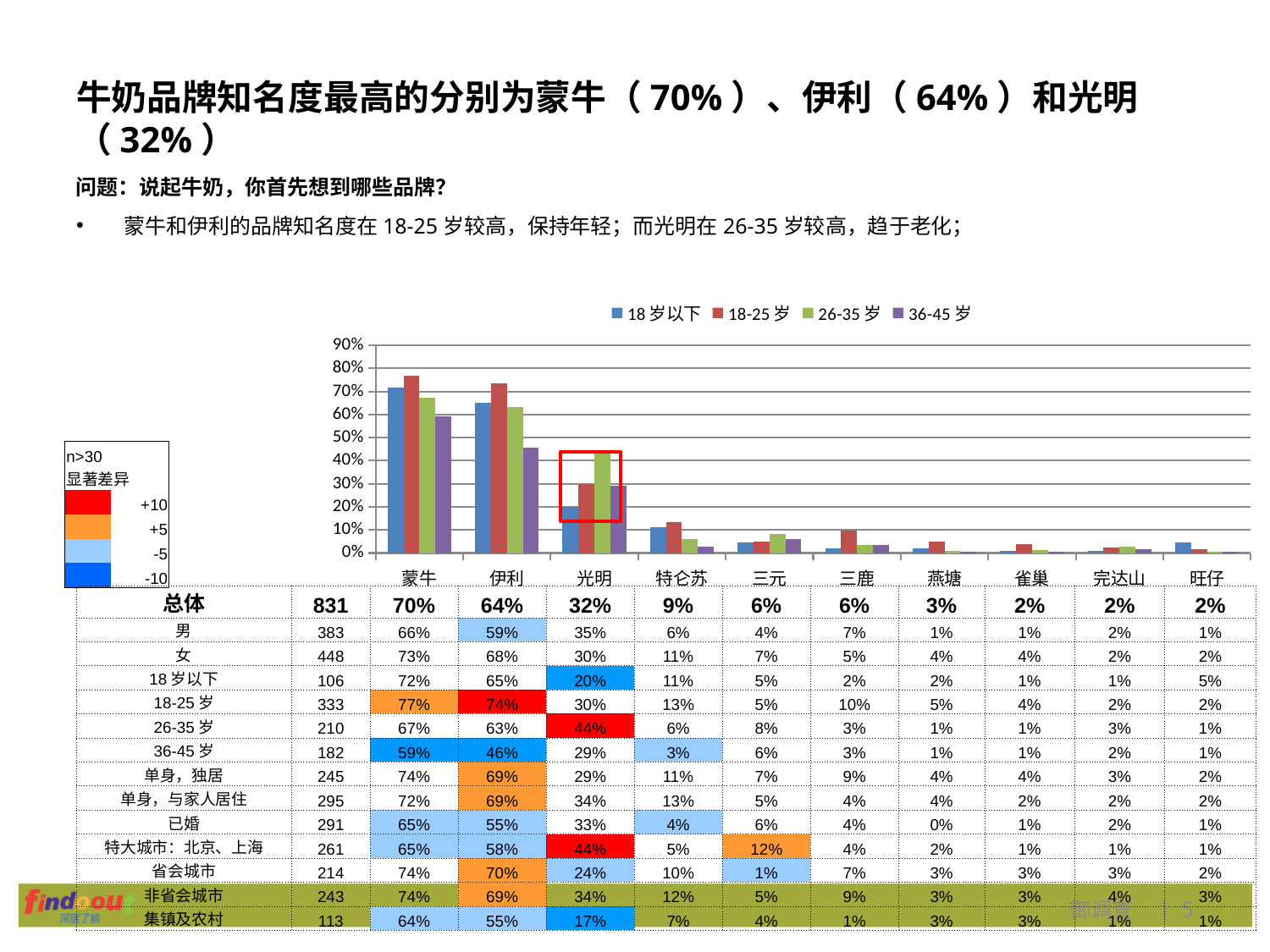
Which brand's bars are enclosed by the red box on the chart? 光明 Is the value for 蒙牛 in the 18-25 岁 series greater or less than 70%? greater What is the value for 光明 in the 26-35 岁 series? 44% How many series does the chart legend list? 4 What is the difference between the 18-25 岁 values for 蒙牛 (77%) and 伊利 (74%)? 3% How many milk brands are shown along the x axis of the chart? 10 What kind of chart is shown on the slide? bar chart Is the value for 光明 in the 18 岁以下 series greater or less than 30%? less For the 18 岁以下 series, which brand has the larger value, 蒙牛 or 伊利? 蒙牛 What is the value for 蒙牛 in the 36-45 岁 series? 59% Which brand has the highest bar for the 18-25 岁 series? 蒙牛 Do the bar heights generally rise or fall moving from 蒙牛 on the left to 旺仔 on the right? fall